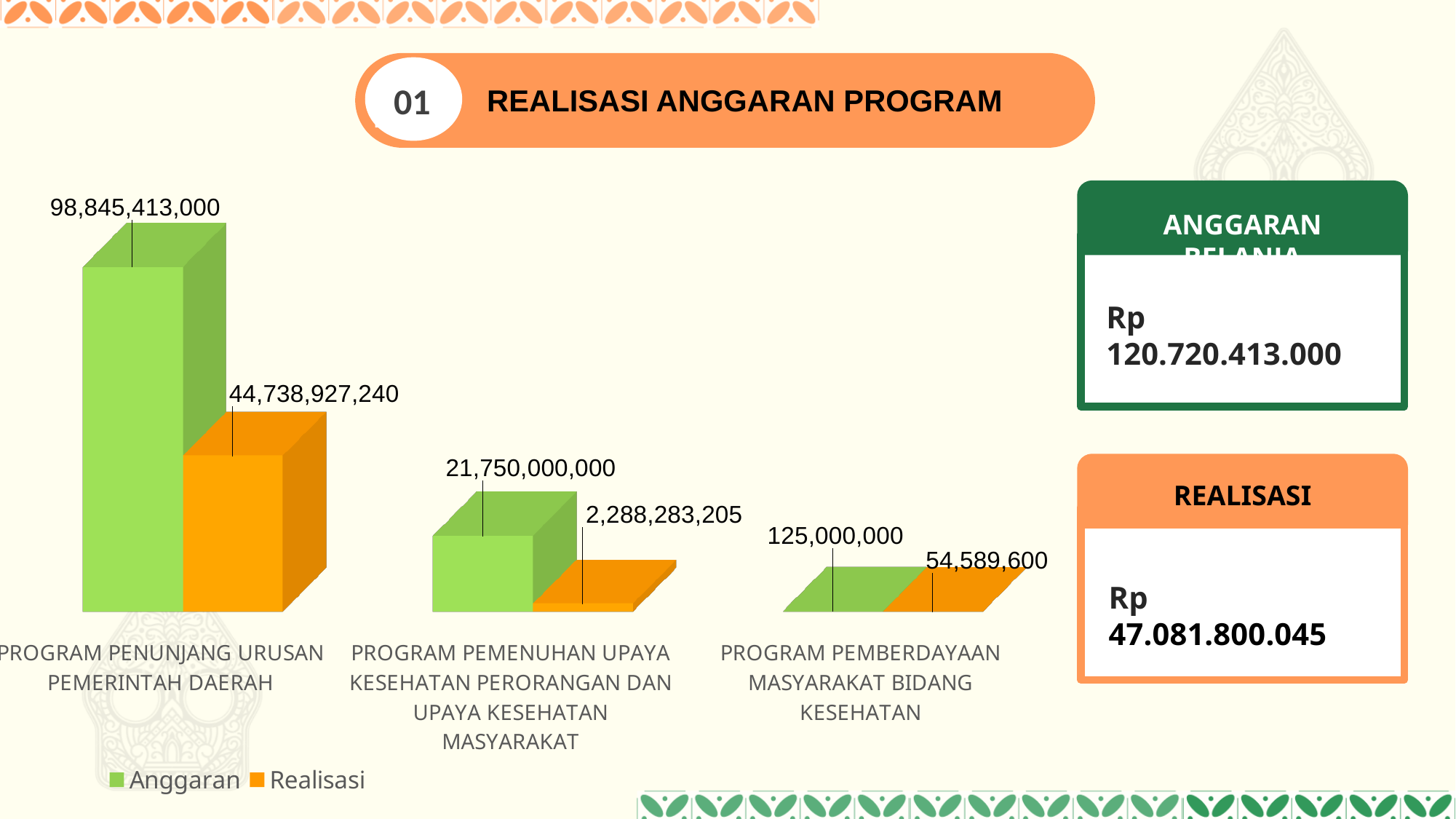
What is the Realisasi value for Program Penunjang Urusan Pemerintah Daerah? 44,738,927,240 Which program has the highest Anggaran value? Program Penunjang Urusan Pemerintah Daerah What is the Anggaran value for Program Penunjang Urusan Pemerintah Daerah? 98,845,413,000 How many program categories are shown on the chart? 3 Which program has the lowest Realisasi value? Program Pemberdayaan Masyarakat Bidang Kesehatan What is the Anggaran value for Program Pemenuhan Upaya Kesehatan Perorangan dan Upaya Kesehatan Masyarakat? 21,750,000,000 What is the difference between Anggaran and Realisasi for Program Pemberdayaan Masyarakat Bidang Kesehatan? 70,410,400 What type of chart is shown on the slide? Bar chart Which is larger for Program Pemenuhan Upaya Kesehatan Perorangan dan Upaya Kesehatan Masyarakat, Anggaran or Realisasi? Anggaran Which colour represents the Realisasi series in the chart? Orange What is the Realisasi value for Program Pemberdayaan Masyarakat Bidang Kesehatan? 54,589,600 How many series does the chart legend list? 2